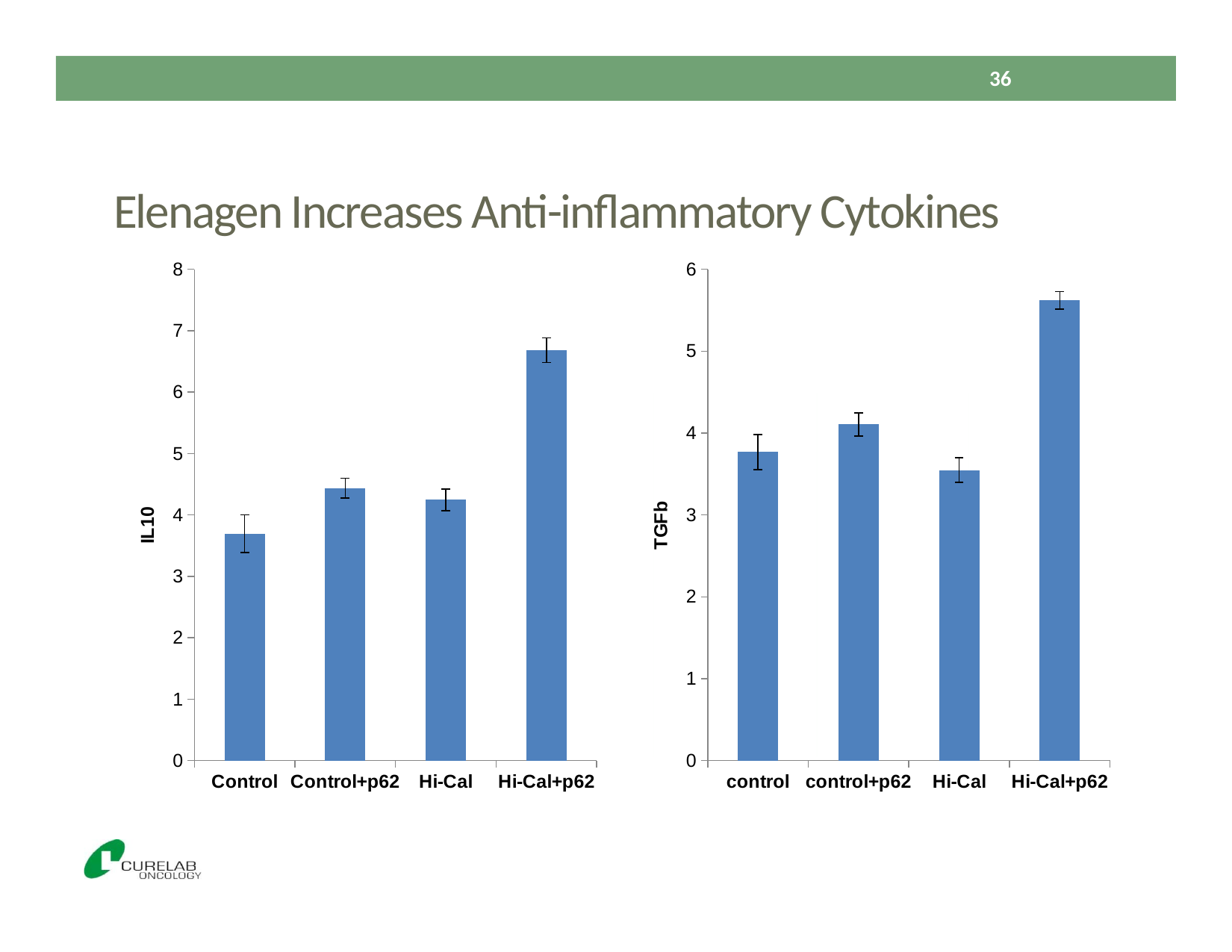
On the right chart (TGFb), which is larger, the value for control+p62 or the value for Hi-Cal? control+p62 On the right chart (TGFb), is the value for Hi-Cal greater or less than 4? less What kind of chart is the left chart (IL10)? bar chart How many categories are shown on the left chart (IL10)? 4 On the right chart (TGFb), is the value for Hi-Cal+p62 greater or less than 5? greater On the left chart (IL10), is the value for Hi-Cal+p62 greater or less than 6? greater On the right chart (TGFb), which category has the highest value? Hi-Cal+p62 On the left chart (IL10), which category has the highest value? Hi-Cal+p62 On the left chart (IL10), which category has the lowest value? Control On the left chart (IL10), which is larger, the value for Hi-Cal+p62 or the value for Hi-Cal? Hi-Cal+p62 What is the y-axis title of the right chart? TGFb